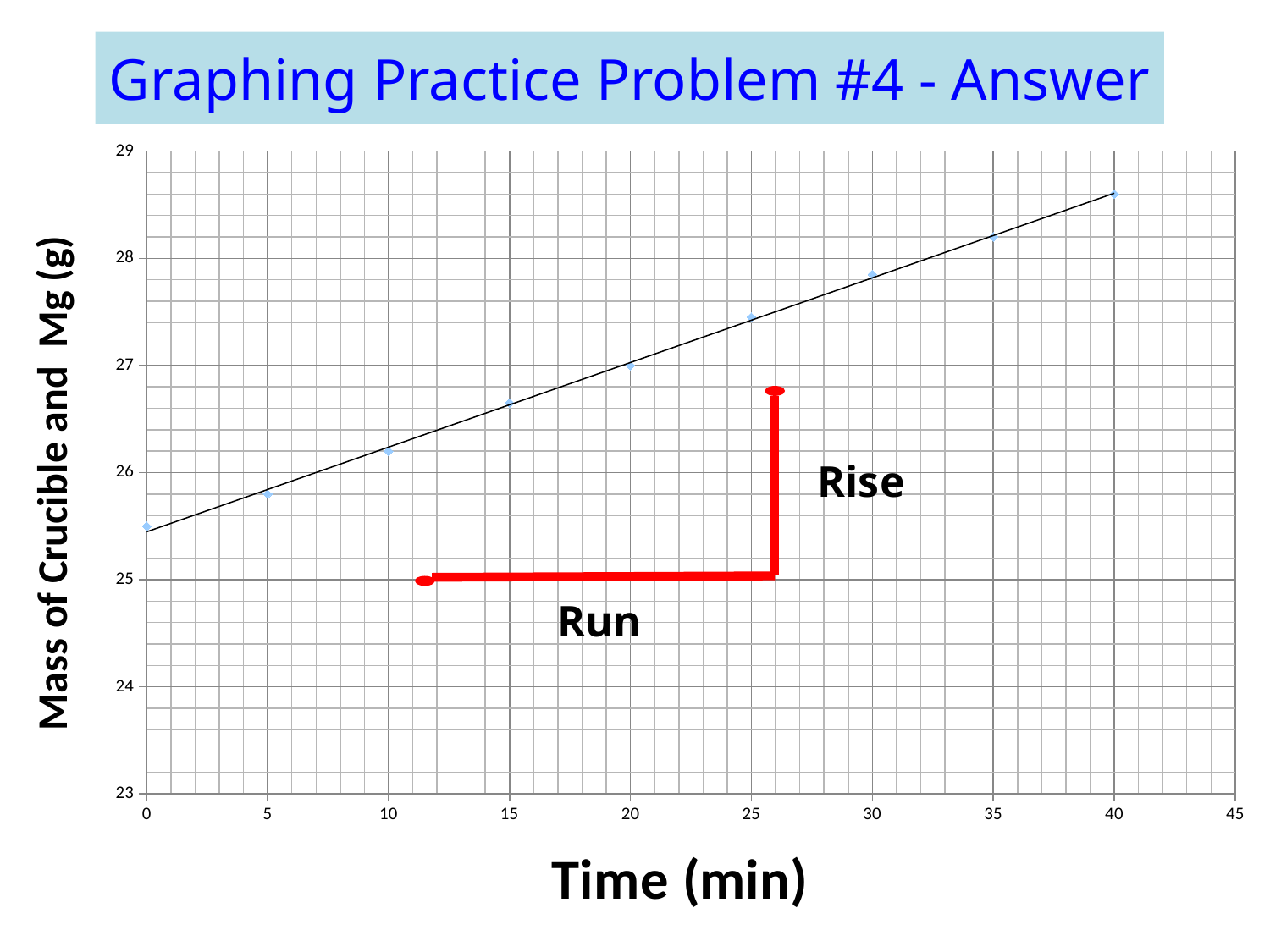
What is the label of the x axis? Time (min) Is the mass at 30 min greater or less than 28 g? less Is the mass at 0 min greater or less than 26 g? less How many data points are plotted on the chart? 9 Which is larger, the mass at 35 min or the mass at 15 min? 35 min What two words label the red slope triangle drawn on the chart? Rise and Run At which time is the mass of crucible and Mg highest? 40 min Do the plotted values rise or fall as time increases along the x axis? rise Is the mass at 40 min greater or less than 28 g? greater What kind of chart is shown on the slide? scatter plot with a trend line At which time is the mass of crucible and Mg lowest? 0 min